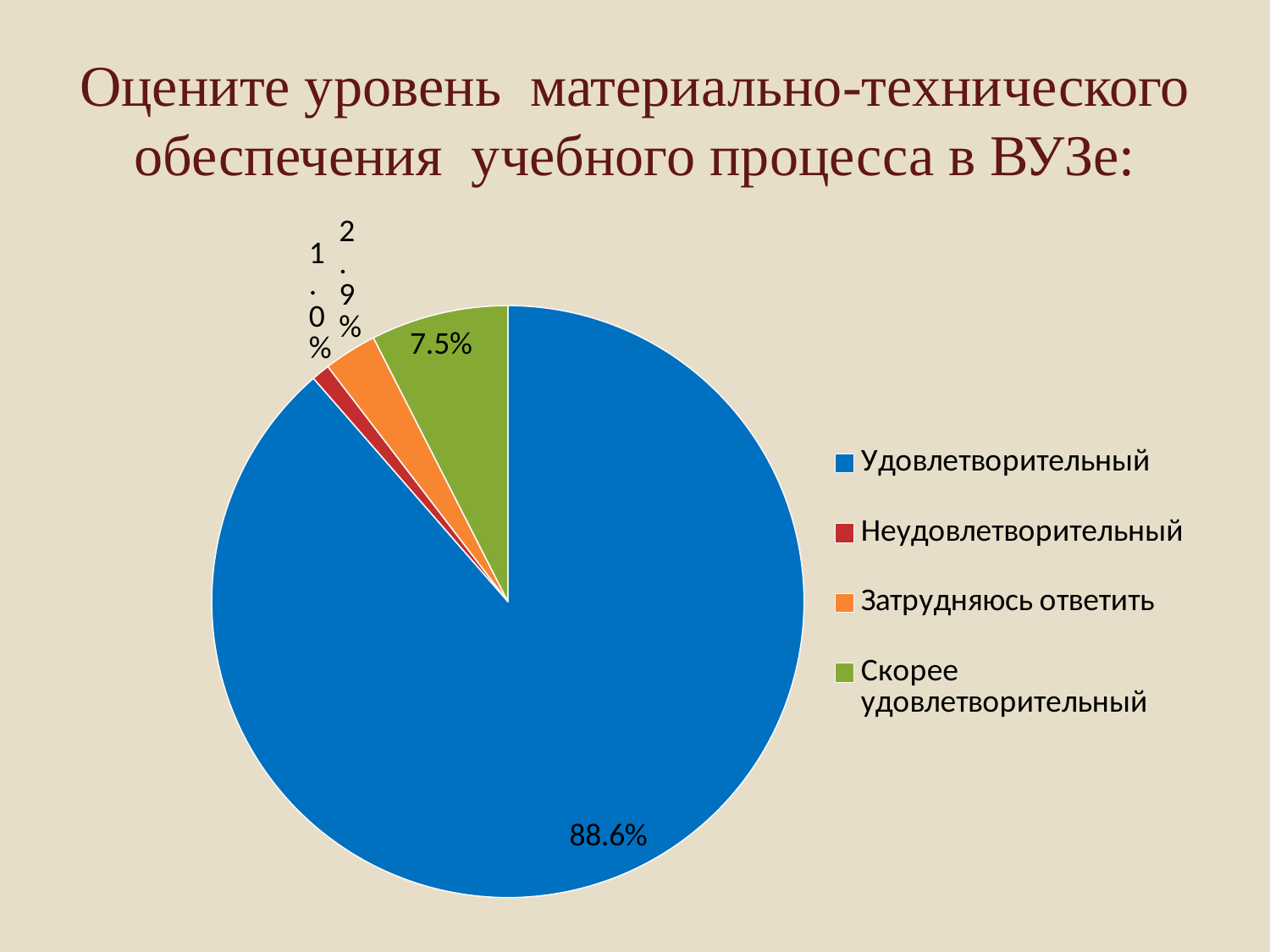
What share of the pie does "Удовлетворительный" have? 88.6% What kind of chart is shown on the slide? pie chart What share of the pie does "Затрудняюсь ответить" have? 2.9% What colour is the slice for "Скорее удовлетворительный"? green What share of the pie does "Скорее удовлетворительный" have? 7.5% Which is larger: the share of "Затрудняюсь ответить" or the share of "Неудовлетворительный"? Затрудняюсь ответить Which category has the largest slice of the pie? Удовлетворительный What is the title of the chart on the slide? Оцените уровень материально-технического обеспечения учебного процесса в ВУЗе: Which category has the smallest slice of the pie? Неудовлетворительный What is the difference between the shares of "Удовлетворительный" and "Скорее удовлетворительный"? 81.1% What share of the pie does "Неудовлетворительный" have? 1.0% How many categories does the pie chart have? 4